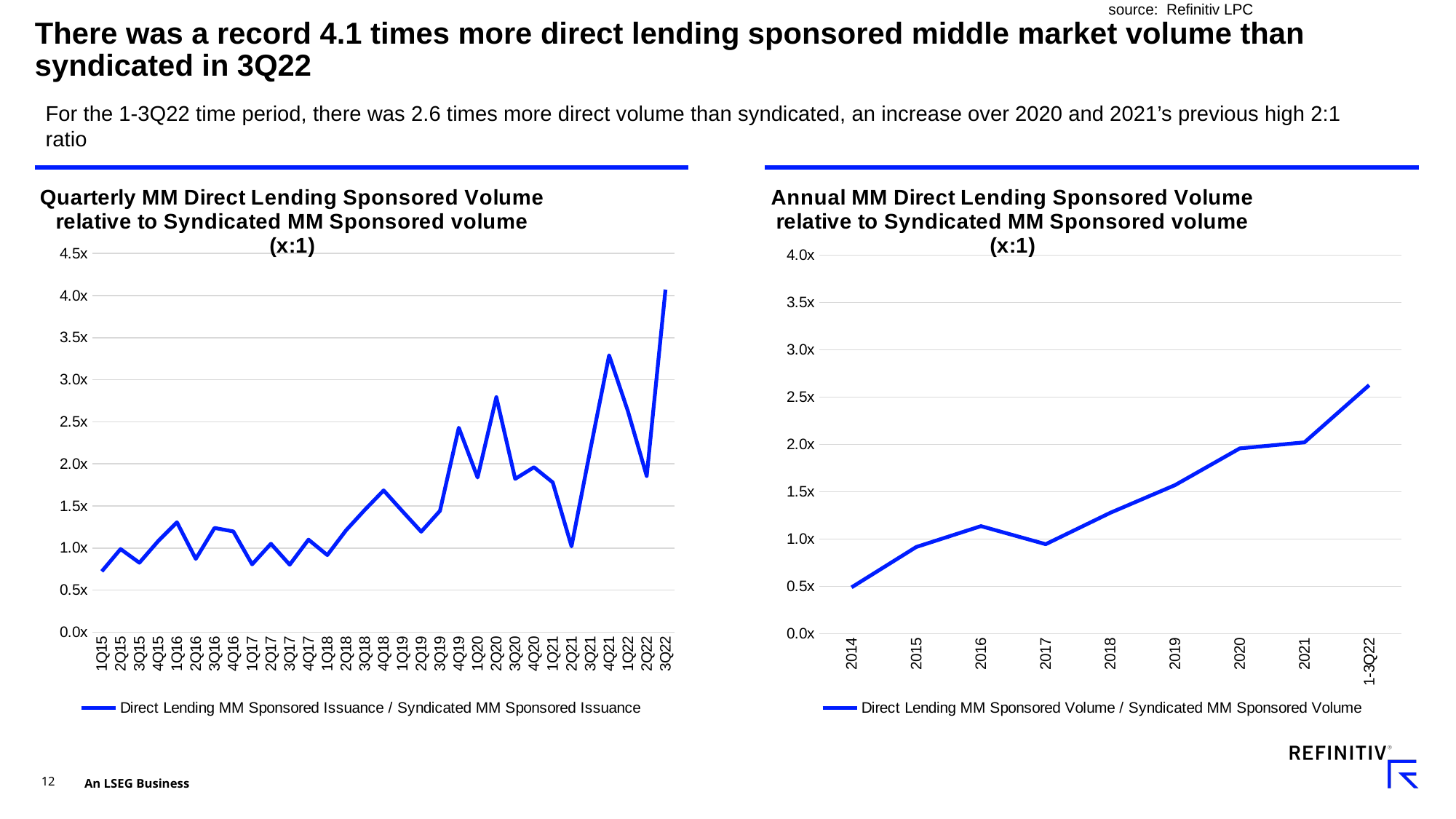
In the quarterly chart on the left, is the value for 4Q21 greater or less than 3.0x? greater In the annual chart on the right, which period has the highest ratio? 1-3Q22 In the quarterly chart on the left, which quarter has the highest ratio? 3Q22 What kind of chart is the 'Quarterly MM Direct Lending Sponsored Volume relative to Syndicated MM Sponsored volume' chart on the left? line chart In the quarterly chart on the left, is the value for 2Q20 greater or less than 2.5x? greater How many series does the legend of the annual chart on the right list? 1 In the annual chart on the right, which year has the lowest ratio? 2014 In the quarterly chart on the left, which is larger, the value for 4Q21 or the value for 1Q22? 4Q21 In the annual chart on the right, is the value for 2014 greater or less than 1.0x? less How many quarters are plotted on the x axis of the quarterly chart on the left? 31 In the annual chart on the right, which is larger, the value for 2016 or the value for 2017? 2016